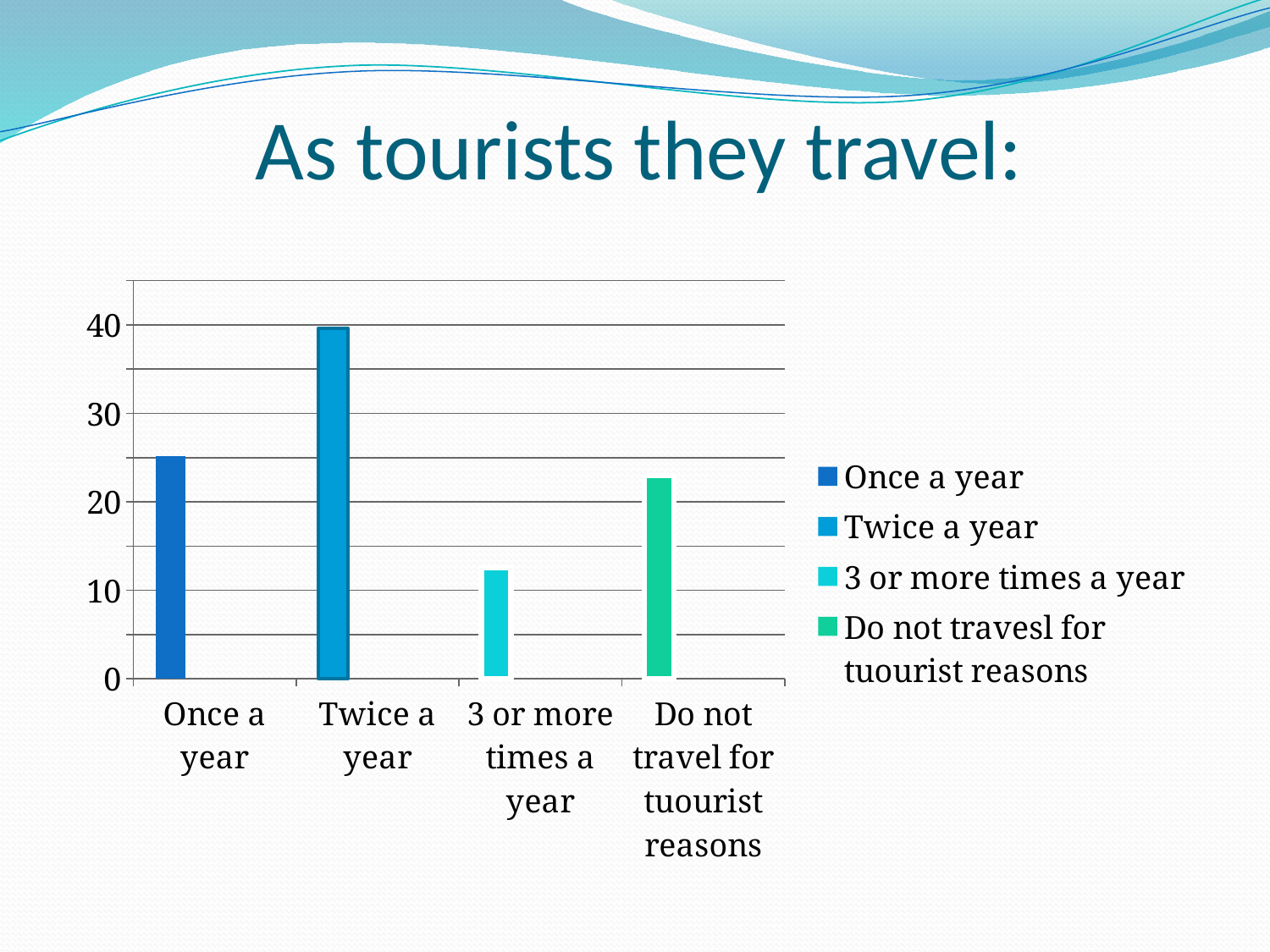
What is the title of the slide containing the chart? As tourists they travel: Is the value for Twice a year greater or less than 30? greater Which category has the highest bar in the chart? Twice a year How many categories are shown on the x axis of the chart? 4 Is the value for Once a year greater or less than 20? greater Which category has the lowest bar in the chart? 3 or more times a year Is the value for Do not travel for tuourist reasons greater or less than 30? less How many entries does the chart's legend list? 4 Which is larger, the value for Twice a year or the value for Do not travel for tuourist reasons? Twice a year What kind of chart is shown on the slide? bar chart Which is larger, the value for Once a year or the value for 3 or more times a year? Once a year